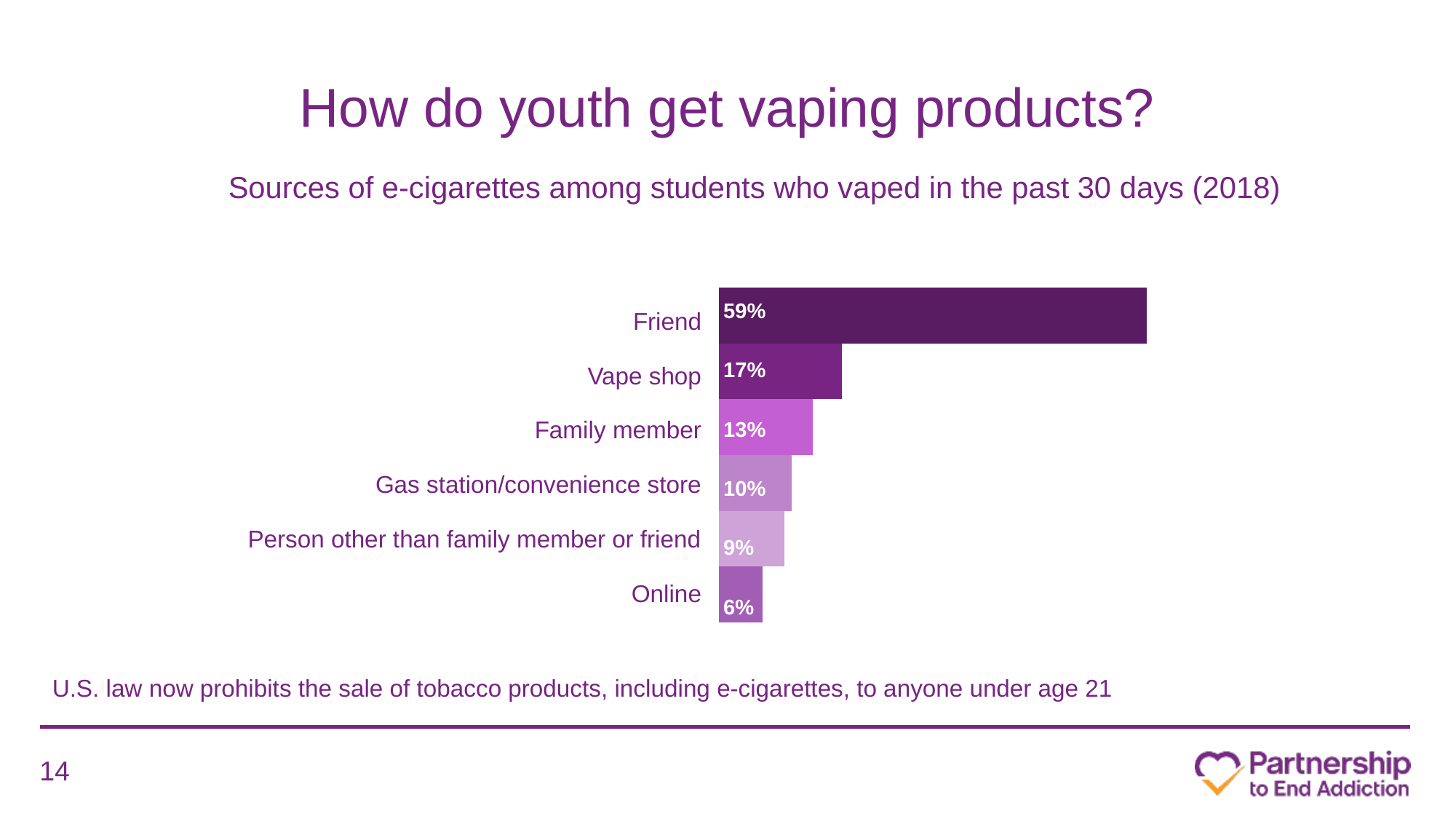
Which source has the highest percentage? Friend What percentage of students who vaped in the past 30 days got e-cigarettes from a friend? 59% What is the value shown for Vape shop? 17% What is the value for Online? 6% How many sources are shown in the chart? 6 What kind of chart is shown on the slide? Bar chart What is the difference between Family member and Online? 7% What is the subtitle describing the chart? Sources of e-cigarettes among students who vaped in the past 30 days (2018) What is the difference between the Friend and Vape shop percentages? 42% Which source has the lowest percentage? Online Which is larger, Family member or Person other than family member or friend? Family member What percentage is shown for Gas station/convenience store? 10%